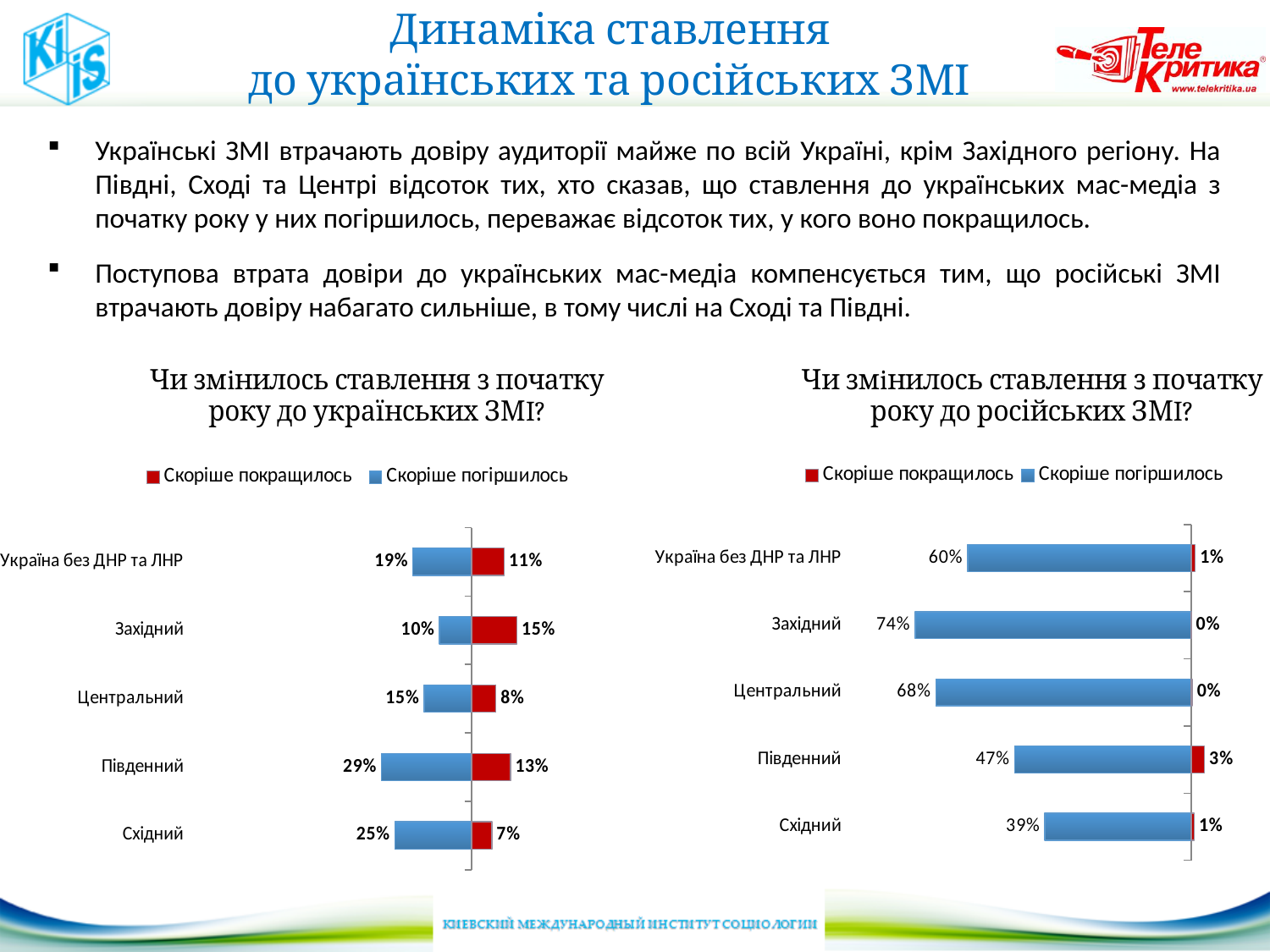
What type of chart is 'Чи змінилось ставлення з початку року до російських ЗМІ?'? Bar chart In the chart 'Чи змінилось ставлення з початку року до російських ЗМІ?', is the 'Скоріше погіршилось' value larger for Центральний or for Південний? Центральний In the chart 'Чи змінилось ставлення з початку року до українських ЗМІ?', what is the difference between 'Скоріше погіршилось' and 'Скоріше покращилось' for Східний? 18% In the chart 'Чи змінилось ставлення з початку року до російських ЗМІ?', what is the difference between the 'Скоріше погіршилось' values for Західний and Східний? 35% In the chart 'Чи змінилось ставлення з початку року до російських ЗМІ?', what is the value of 'Скоріше покращилось' for Південний? 3% In the chart 'Чи змінилось ставлення з початку року до українських ЗМІ?', which region has the lowest 'Скоріше покращилось' value? Східний In the chart 'Чи змінилось ставлення з початку року до російських ЗМІ?', what is the value of 'Скоріше погіршилось' for Західний? 74% In the chart 'Чи змінилось ставлення з початку року до українських ЗМІ?', which region has the highest 'Скоріше погіршилось' value? Південний In the chart 'Чи змінилось ставлення з початку року до українських ЗМІ?', what is the value of 'Скоріше покращилось' for Західний? 15% In the chart 'Чи змінилось ставлення з початку року до російських ЗМІ?', which region has the lowest 'Скоріше погіршилось' value? Східний How many regions (categories) are shown in the chart 'Чи змінилось ставлення з початку року до українських ЗМІ?'? 5 In the chart 'Чи змінилось ставлення з початку року до українських ЗМІ?', what is the value of 'Скоріше погіршилось' for Південний? 29%